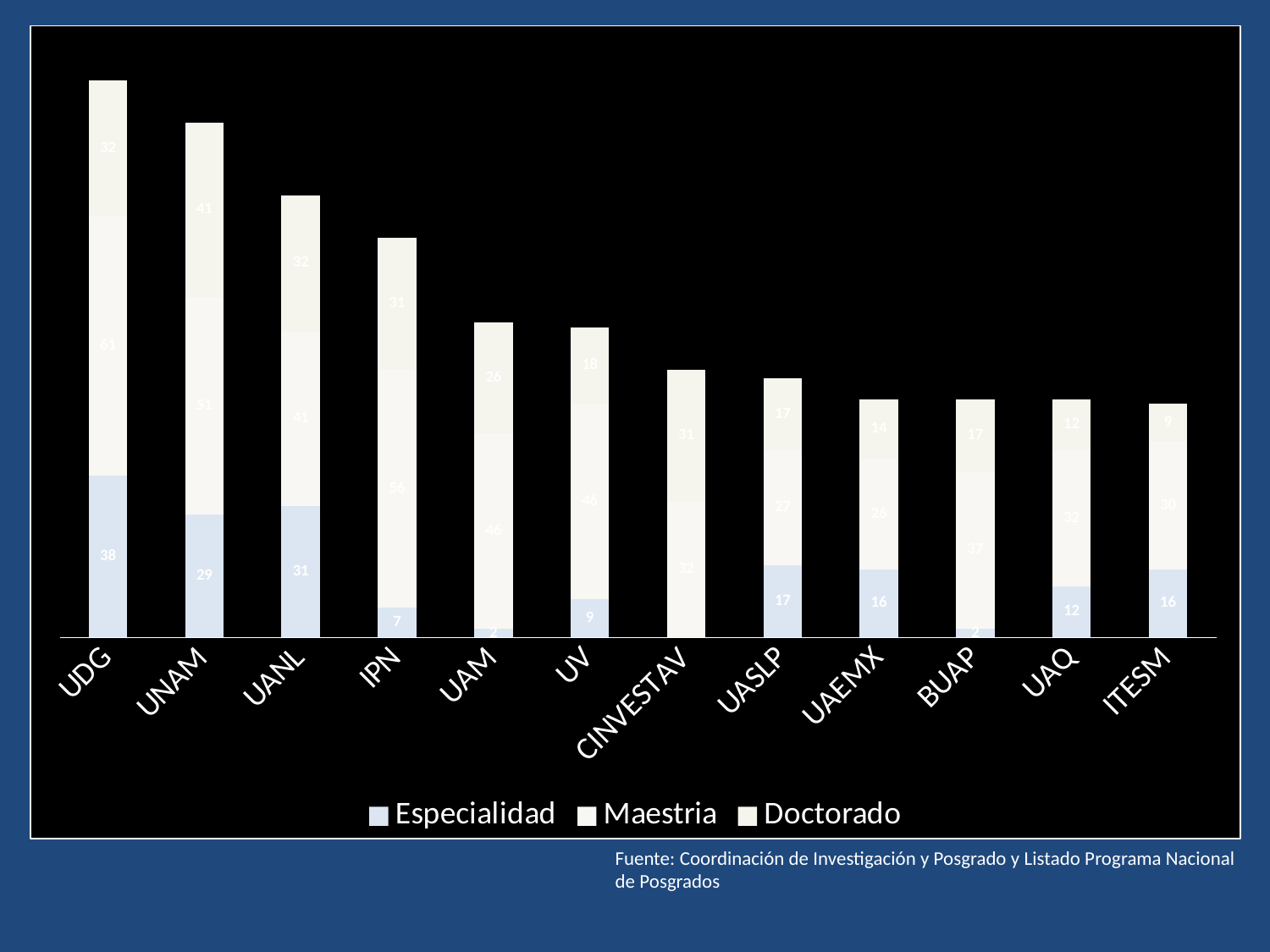
What kind of chart is shown on the slide? stacked bar chart Which institution has the largest Especialidad value? UDG What is the Especialidad value for UNAM? 29 Which is larger, the Especialidad value for UANL or for UNAM? UANL What is the Especialidad value for IPN? 7 Do the total bar heights rise or fall from left to right along the x axis? fall How many institutions are shown along the x axis? 12 What is the Especialidad value for UDG? 38 Which institution has the tallest stacked bar overall? UDG What is the Especialidad value for UASLP? 17 How many series does the legend list? 3 Which series is shown in light blue at the bottom of each bar? Especialidad